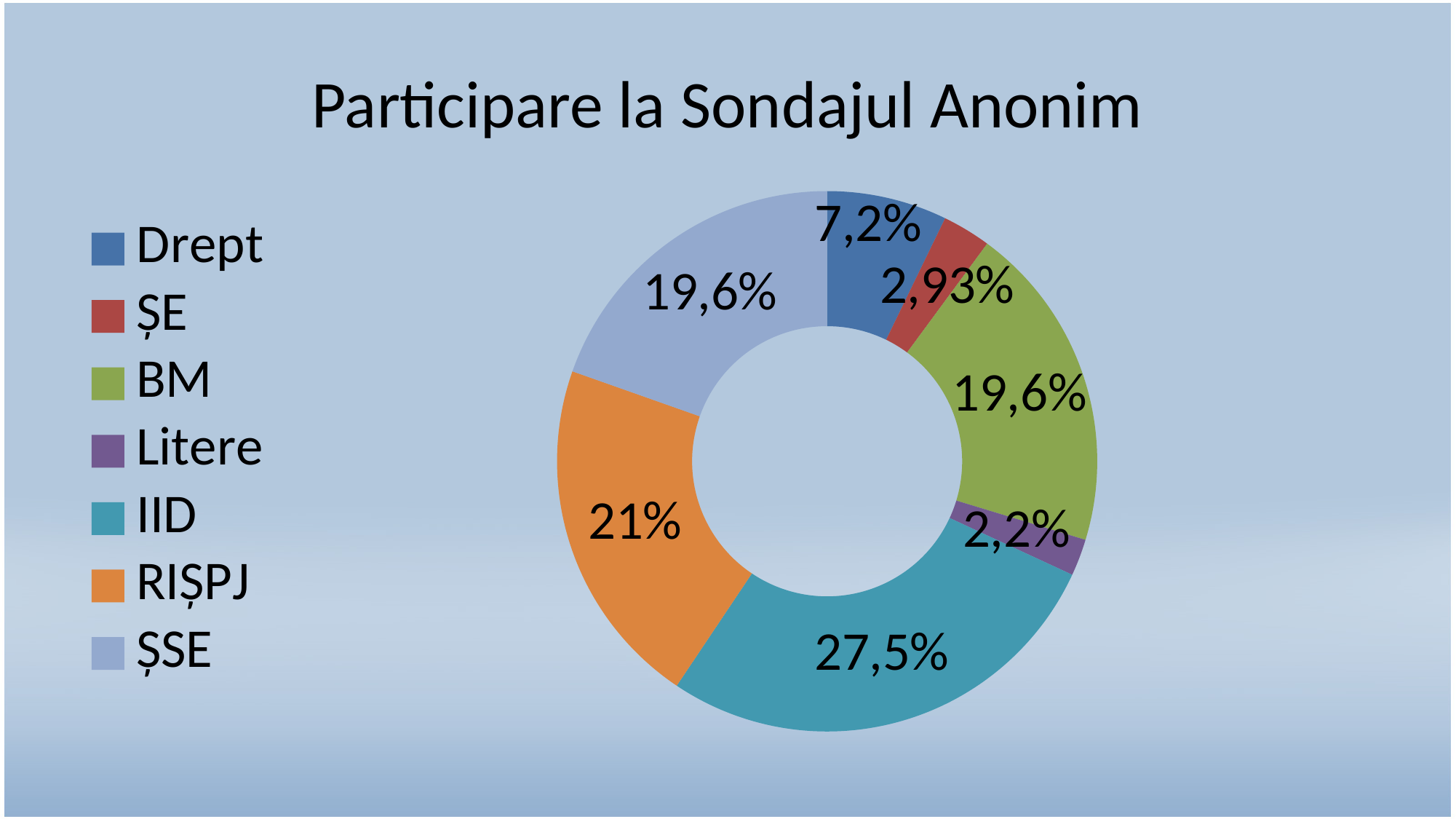
What kind of chart is shown on the slide? Doughnut (pie) chart What share does Drept have in the chart? 7,2% What share does ȘE have in the chart? 2,93% What share does RIȘPJ have in the chart? 21% Which has the larger share, Drept or ȘE? Drept What share does IID have in the chart? 27,5% What is the difference in percentage points between the shares of IID and RIȘPJ? 6,5 What is the title of the chart? Participare la Sondajul Anonim Which category has the largest share? IID Which category has the smallest share? Litere What share does Litere have in the chart? 2,2% How many categories does the legend list? 7